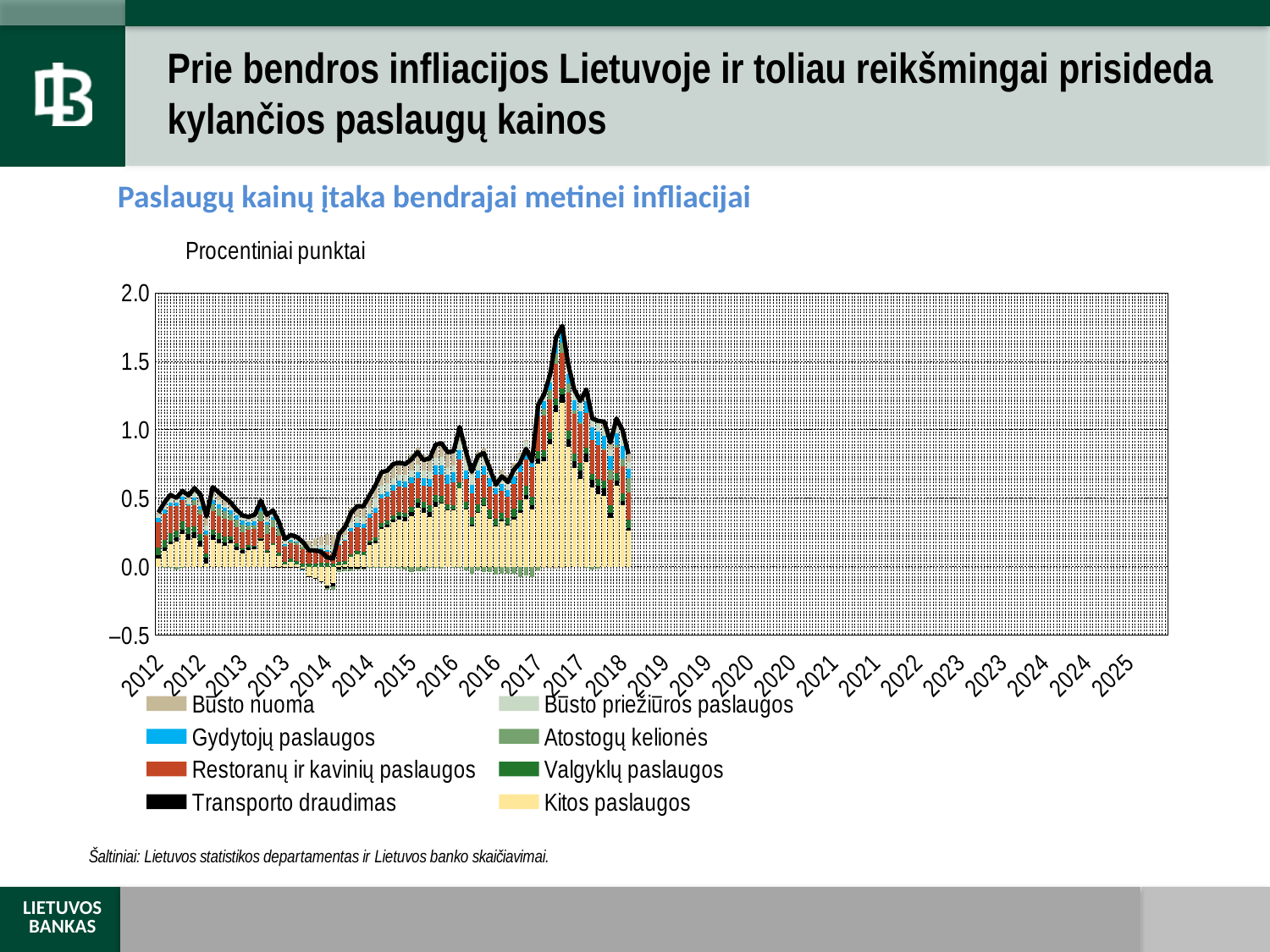
In which year does the black line reach its lowest value? 2014 Is the peak value of the black line in 2017 greater or less than 1.5? greater Is the value of the black line at the start of 2012 greater or less than 1.0? less Which legend entry is shown in yellow? Kitos paslaugos What is the title of the chart? Paslaugų kainų įtaka bendrajai metinei infliacijai Does the black line rise or fall between 2014 and 2017? rise In which year does the black line reach its highest value? 2017 What kind of chart is shown on the slide? Stacked bar chart with a line Is the value of the black line in early 2014 greater or less than 0.5? less How many series does the legend list? 8 Which series contributes the largest share of the stacked bars in 2017? Kitos paslaugos Does the black line rise or fall between 2012 and 2014? fall